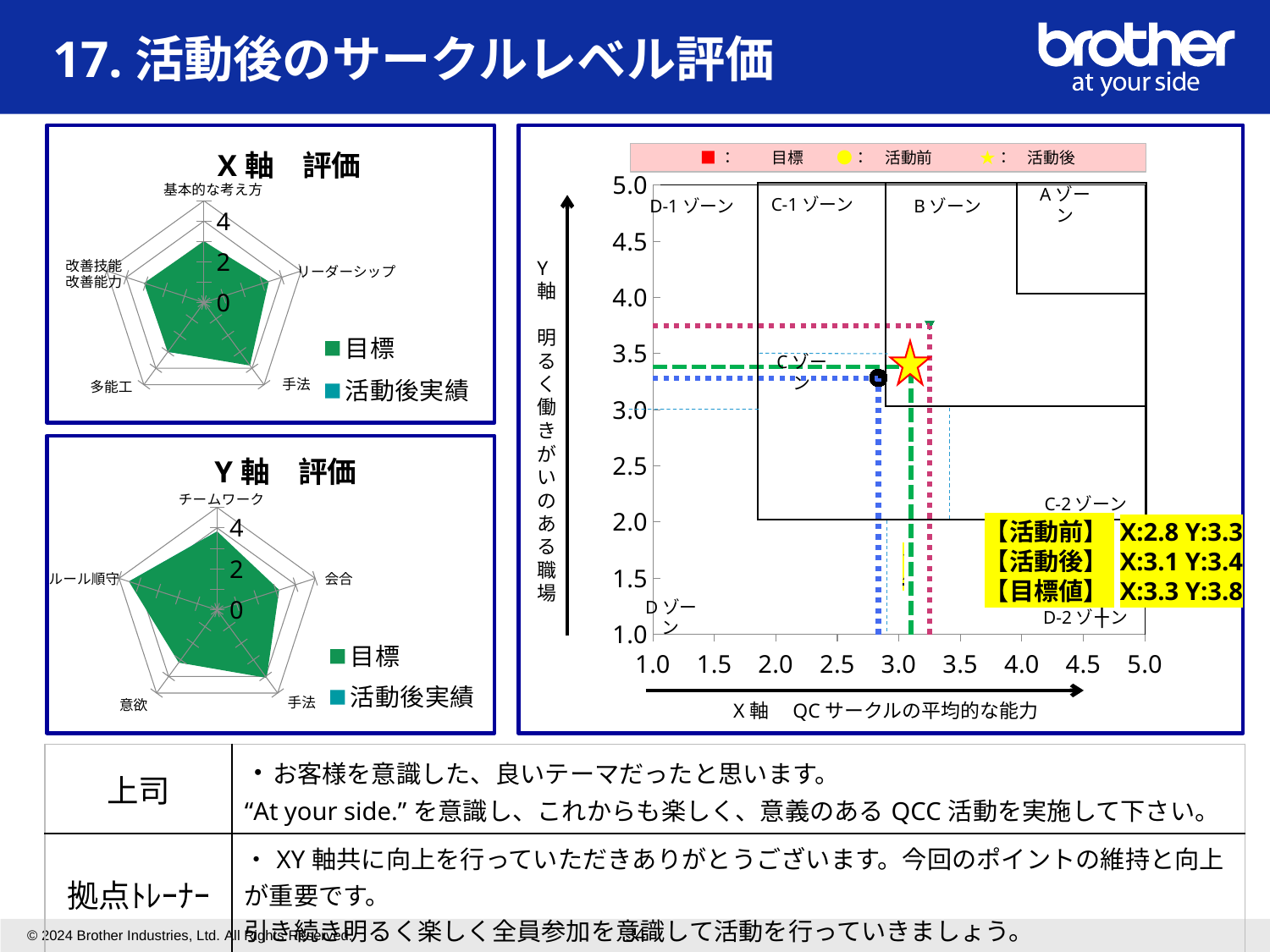
On the Y軸 評価 radar chart, how many categories (axes) are plotted? 5 On the right-hand scatter chart, what is the Y value for 活動後? 3.4 What kind of chart is the X軸 評価 chart? radar chart On the right-hand scatter chart, what is the X value for 目標値? 3.3 On the right-hand scatter chart, how many series does the legend list? 3 On the right-hand scatter chart, what is the difference between the Y value of 目標値 and the Y value of 活動前? 0.5 On the right-hand scatter chart, which has the larger X value, 活動前 or 活動後? 活動後 On the right-hand scatter chart, what is the X value for 活動前? 2.8 What kind of chart is the right-hand chart with the X軸 and Y軸 axes? scatter chart On the X軸 評価 radar chart, how many categories (axes) are plotted? 5 On the X軸 評価 chart, how many series does the legend list? 2 On the Y軸 評価 chart, what are the two legend entries? 目標, 活動後実績